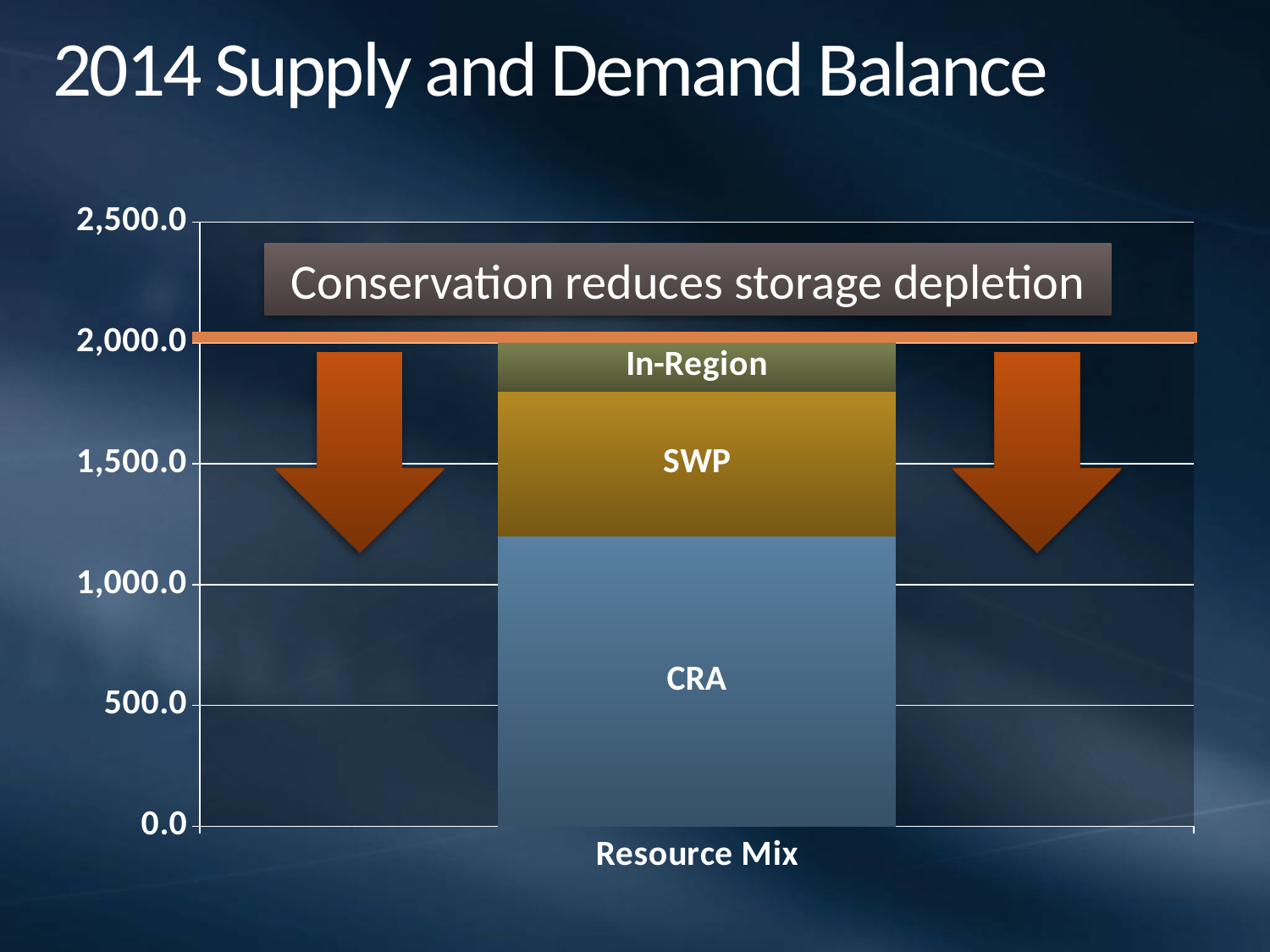
Is the total height of the Resource Mix stacked bar greater or less than 1,500.0? greater Is the value of the CRA segment greater or less than 1,000.0? greater Which segment is larger, CRA or SWP? CRA What kind of chart is shown on the slide? stacked bar chart What is the label of the single category on the x axis? Resource Mix Is the value of the In-Region segment greater or less than 500.0? less Which segment of the Resource Mix bar is the smallest? In-Region How many segments make up the stacked bar for Resource Mix? 3 How many categories are shown on the x axis of the chart? 1 Which segment is larger, SWP or In-Region? SWP Which segment of the Resource Mix bar is the largest? CRA What is the title of the slide containing the chart? 2014 Supply and Demand Balance